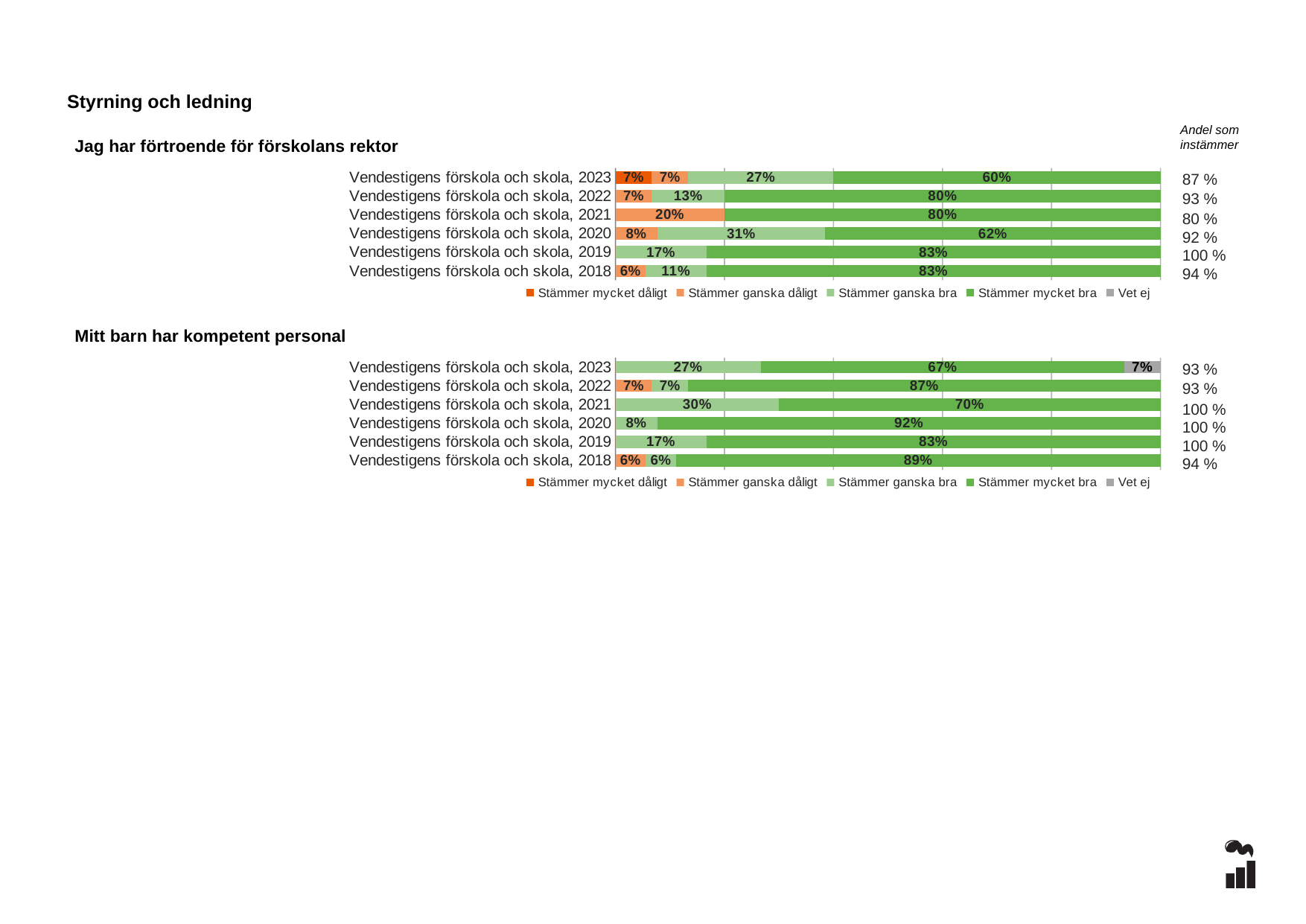
In the chart 'Jag har förtroende för förskolans rektor', what is the 'Andel som instämmer' for Vendestigens förskola och skola, 2019? 100 % In the chart 'Jag har förtroende för förskolans rektor', which year has the highest 'Stämmer ganska bra' value? 2020 In the chart 'Jag har förtroende för förskolans rektor', what is the difference between the 'Stämmer mycket bra' values for 2022 and 2023? 20% How many series does the legend of the chart 'Mitt barn har kompetent personal' list? 5 In the chart 'Mitt barn har kompetent personal', what is the 'Stämmer mycket bra' value for Vendestigens förskola och skola, 2020? 92% What kind of chart is 'Mitt barn har kompetent personal'? Stacked bar chart In the chart 'Mitt barn har kompetent personal', what is the 'Vet ej' value for Vendestigens förskola och skola, 2023? 7% How many bars (years) are shown in the chart 'Jag har förtroende för förskolans rektor'? 6 In the chart 'Jag har förtroende för förskolans rektor', what is the 'Stämmer mycket bra' value for Vendestigens förskola och skola, 2023? 60% In the chart 'Jag har förtroende för förskolans rektor', what is the 'Stämmer ganska dåligt' value for Vendestigens förskola och skola, 2021? 20% In the chart 'Mitt barn har kompetent personal', which year has the lowest 'Stämmer mycket bra' value? 2023 In the chart 'Mitt barn har kompetent personal', is the 'Stämmer mycket bra' value larger for 2021 or for 2018? 2018